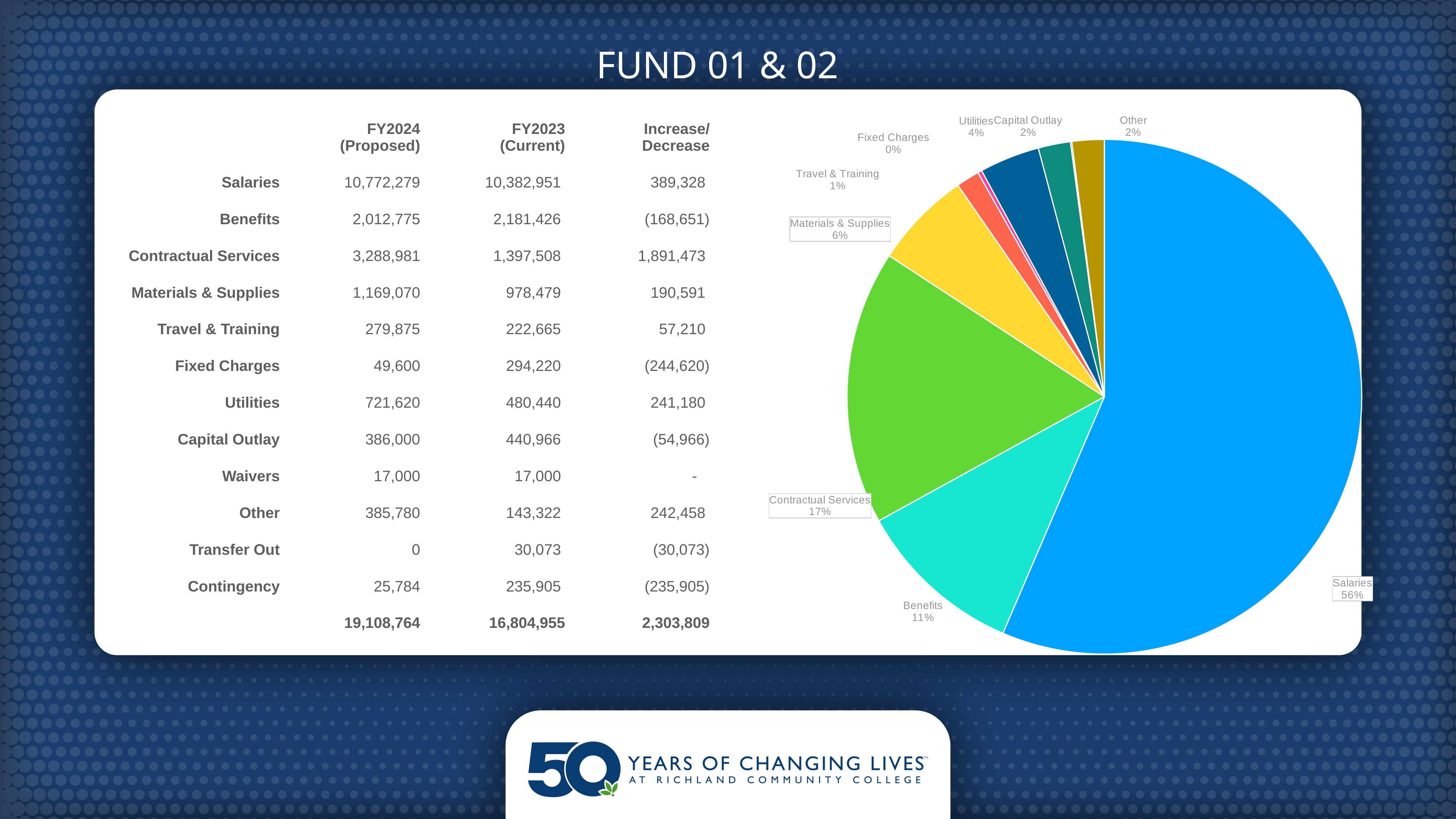
What share of the pie does Materials & Supplies represent? 6% What share of the pie does Contractual Services represent? 17% What percentage is shown for Fixed Charges in the pie chart? 0% What kind of chart is shown on the slide? pie chart What share of the pie does Salaries represent? 56% Which category has the largest slice of the pie? Salaries Which slice is larger, Contractual Services or Benefits? Contractual Services What colour is the Salaries slice of the pie? blue By how many percentage points does the Salaries share exceed the Benefits share? 45% What percentage is shown for Travel & Training in the pie chart? 1%